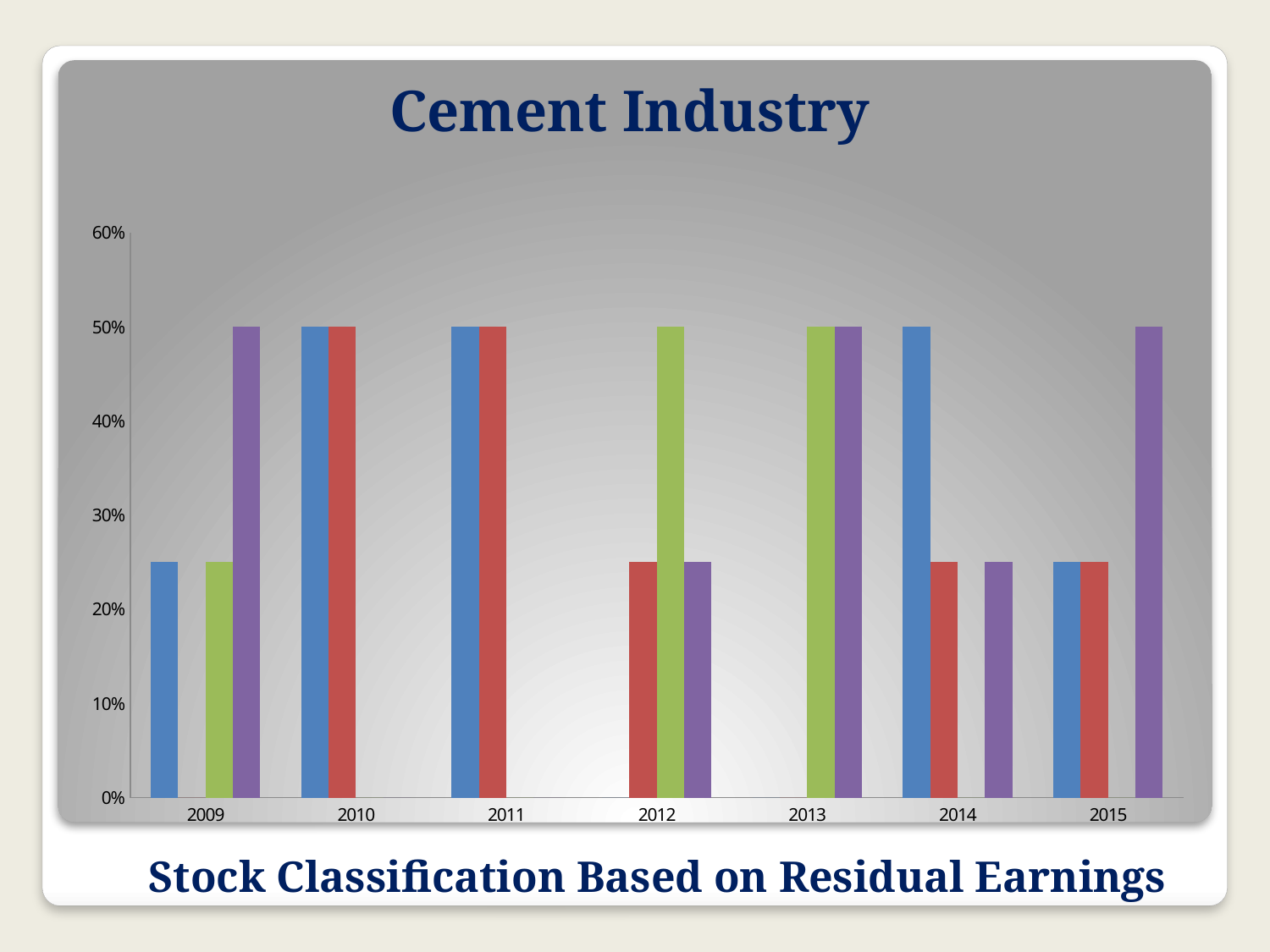
Is the value of the purple bar for 2012 greater or less than 30%? less What is the value of the green bar for 2013? 50% Is the value of the blue bar for 2009 greater or less than 30%? less What is the value of the blue bar for 2010? 50% What is the value of the purple bar for 2015? 50% In 2012, which is larger: the green bar or the red bar? green bar What kind of chart is shown on the slide? bar chart What is the title of the chart? Cement Industry In 2014, which is larger: the blue bar or the purple bar? blue bar How many years are shown along the x axis of the chart? 7 Is the value of the red bar for 2014 greater or less than 20%? greater In 2009, which coloured bar is the highest? purple